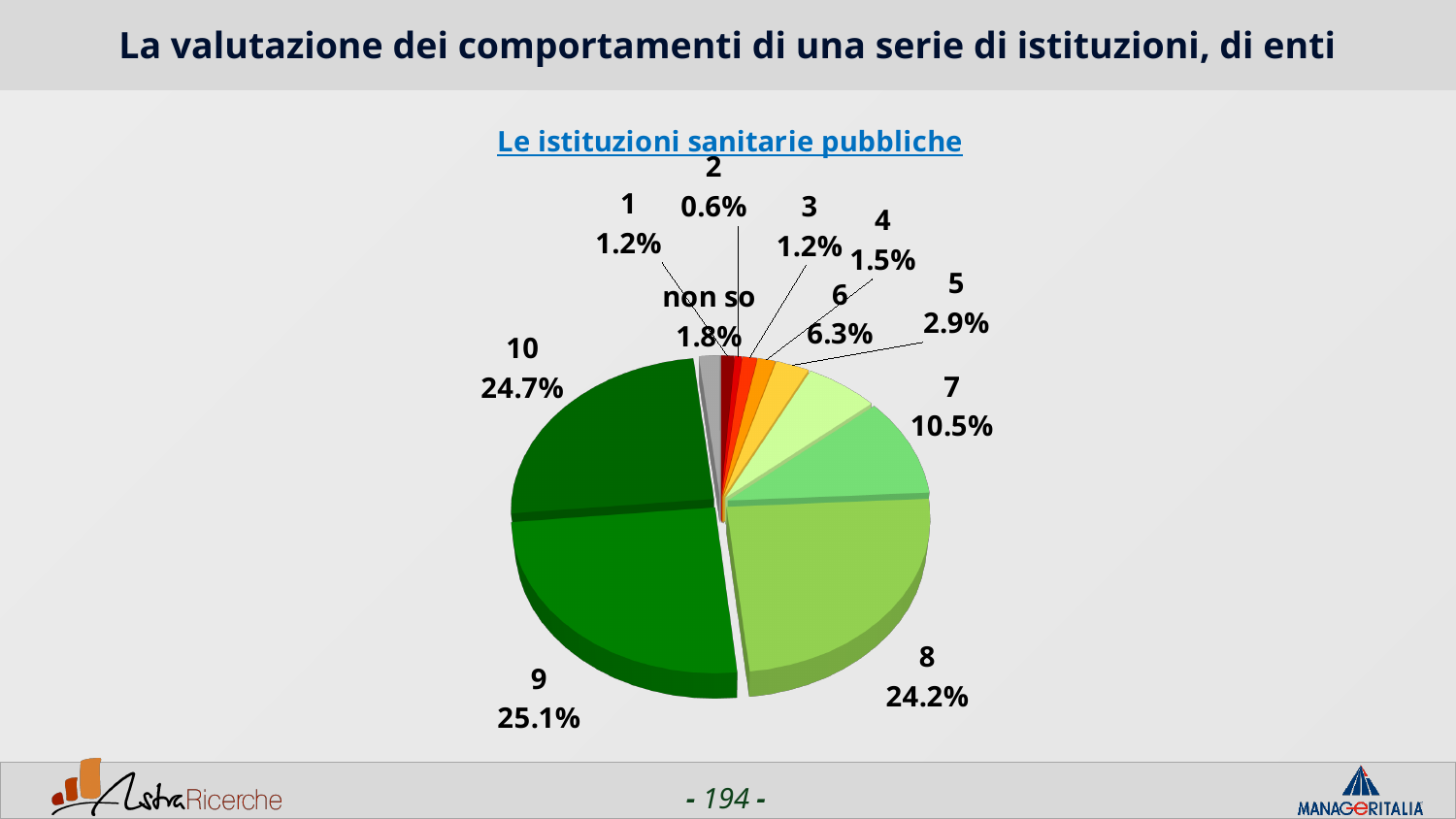
Which category has the smallest slice of the pie? 2 Which is larger, the value for category 7 or the value for category 6? 7 What kind of chart is shown on the slide? pie chart Which category has the largest slice of the pie? 9 What is the value shown for category 7? 10.5% What share of the pie does category 9 have? 25.1% How many slices does the pie chart have? 11 What is the combined share of categories 8, 9 and 10? 74% What is the title of the chart? Le istituzioni sanitarie pubbliche What is the value shown for the 'non so' slice? 1.8% What is the difference between the values for category 10 and category 8? 0.5% What is the value shown for category 6? 6.3%